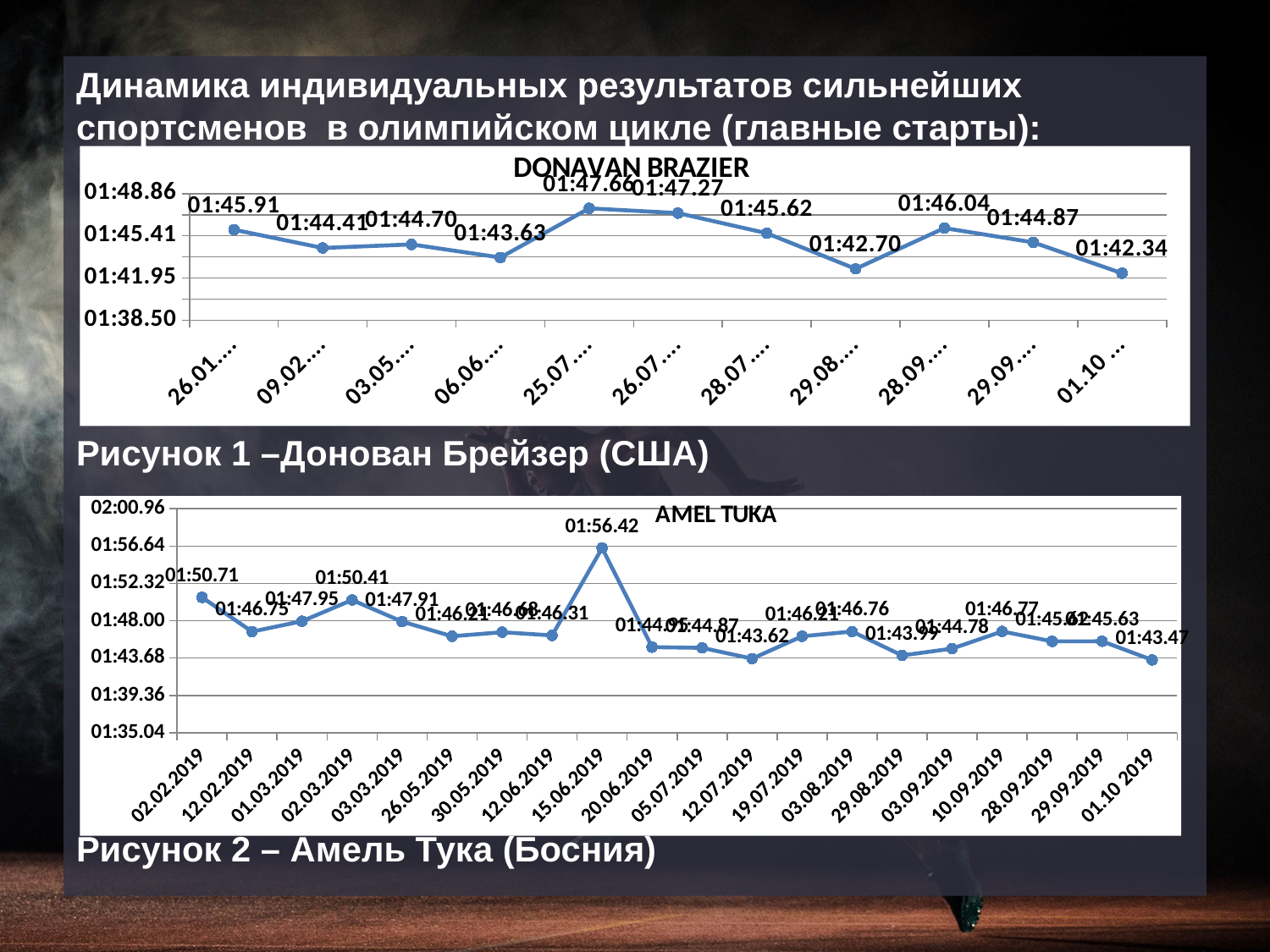
In the AMEL TUKA chart, what is the value for 15.06.2019? 01:56.42 In the AMEL TUKA chart, which is larger: the value for 12.07.2019 or the value for 03.08.2019? 03.08.2019 In the AMEL TUKA chart, which date has the highest value? 15.06.2019 In the DONAVAN BRAZIER chart, what is the lowest value shown? 01:42.34 What type of chart is the DONAVAN BRAZIER chart? line chart In the DONAVAN BRAZIER chart, what is the highest value shown? 01:47.66 In the DONAVAN BRAZIER chart, what is the value of the last data point? 01:42.34 In the AMEL TUKA chart, what is the value for 02.02.2019? 01:50.71 In the DONAVAN BRAZIER chart, what is the value of the first data point? 01:45.91 In the AMEL TUKA chart, what is the value for 02.03.2019? 01:50.41 How many data points are plotted in the DONAVAN BRAZIER chart? 11 How many data points are plotted in the AMEL TUKA chart? 20